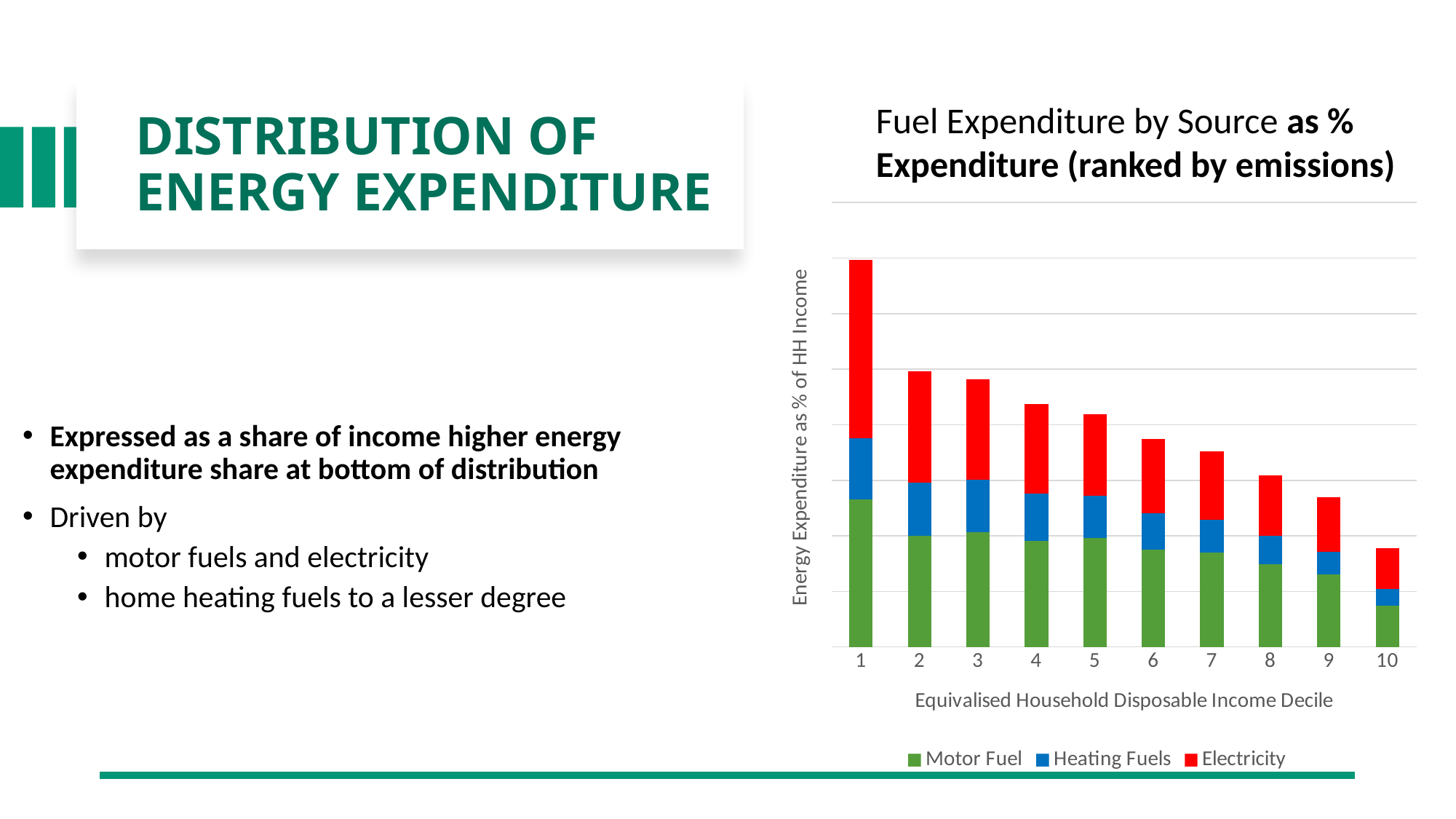
What kind of chart is shown on the slide? Stacked bar chart In decile 1, which fuel source accounts for the largest segment of the bar? Electricity Which has the larger total bar, decile 1 or decile 2? Decile 1 What is the x-axis label of the chart? Equivalised Household Disposable Income Decile How many income deciles are shown on the x axis of the chart? 10 Which has the larger total bar, decile 6 or decile 9? Decile 6 Which income decile has the lowest total energy expenditure as a share of household income? 10 Do the total bar heights rise or fall as the income decile increases from 1 to 10? Fall How many series does the chart legend list? 3 Which series is shown in green in the chart? Motor Fuel Which income decile has the highest total energy expenditure as a share of household income? 1